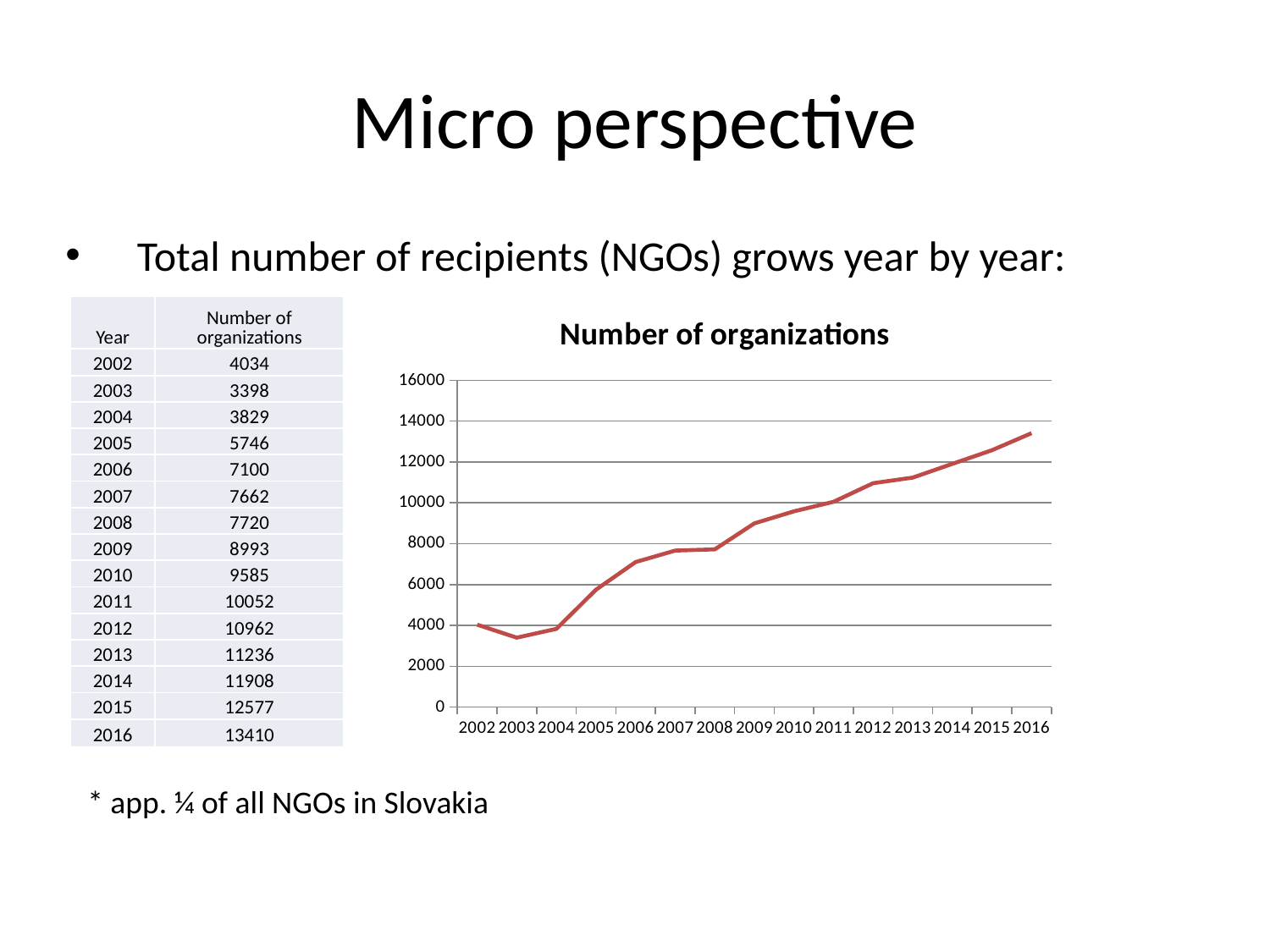
Which year has more organizations, 2005 or 2004? 2005 What is the title of the chart? Number of organizations What type of chart is shown on the slide? line chart According to the table, what is the number of organizations in 2002? 4034 According to the table, what is the number of organizations in 2016? 13410 What is the difference in the number of organizations between 2016 and 2015? 833 How many years are plotted along the x axis of the chart? 15 Which year has the highest number of organizations? 2016 According to the table, what is the number of organizations in 2009? 8993 Does the number of organizations generally rise or fall from 2004 to 2016? rise Is the value for 2012 on the chart greater or less than 10000? greater Which year has the lowest number of organizations? 2003